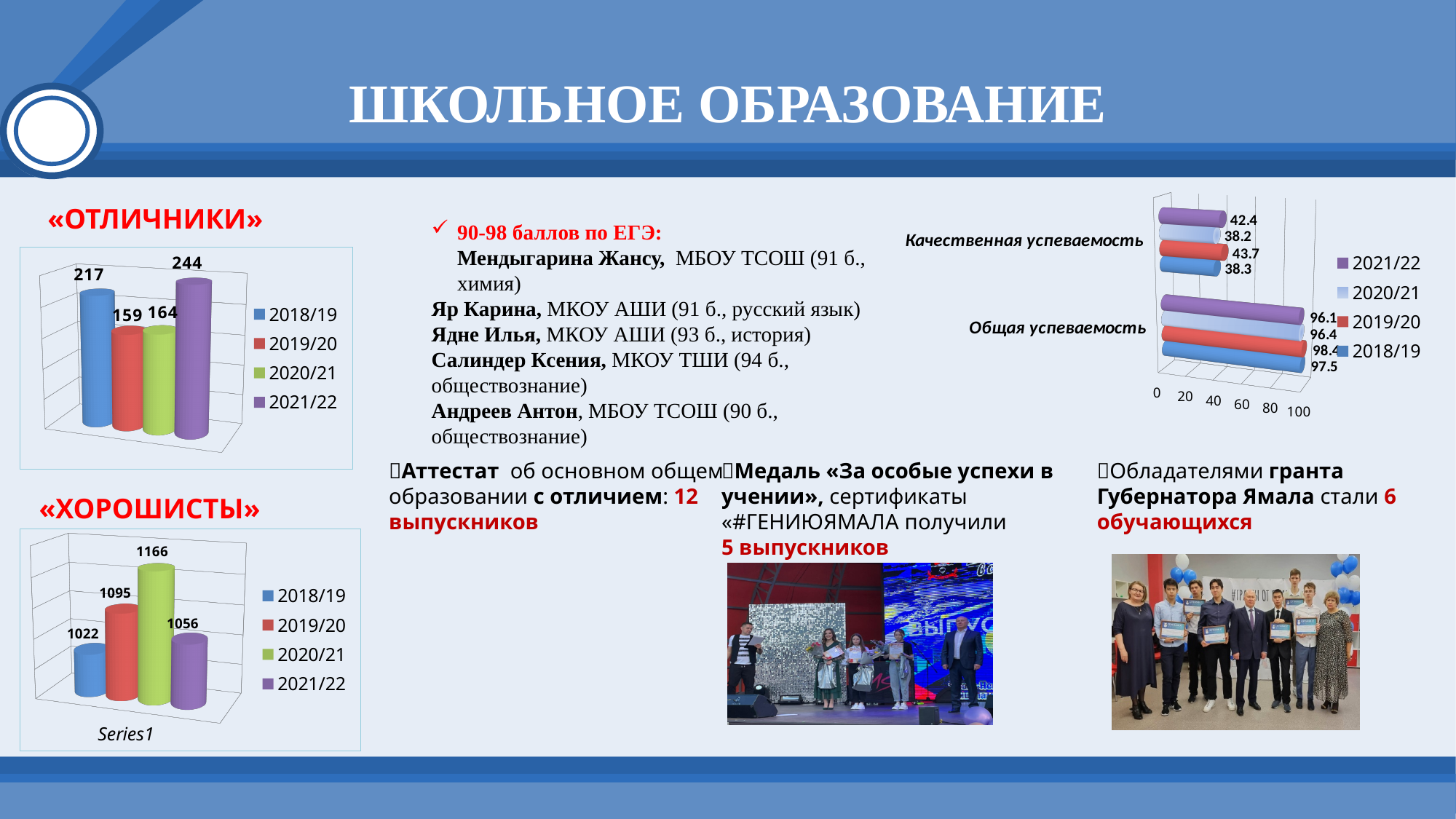
In the «ХОРОШИСТЫ» chart, which is larger, the value for 2019/20 or the value for 2021/22? 2019/20 In the «ОТЛИЧНИКИ» chart, which year has the lowest value? 2019/20 What kind of chart is the «ХОРОШИСТЫ» chart? Bar chart How many series does the legend of the «ОТЛИЧНИКИ» chart list? 4 In the «ХОРОШИСТЫ» chart, what is the value for 2020/21? 1166 In the chart on the right, what is the value of Качественная успеваемость for 2020/21? 38.2 In the «ОТЛИЧНИКИ» chart, what is the value for 2021/22? 244 In the «ХОРОШИСТЫ» chart, which year has the highest value? 2020/21 In the «ОТЛИЧНИКИ» chart, what is the difference between the 2021/22 and 2018/19 values? 27 In the «ХОРОШИСТЫ» chart, what is the difference between the 2020/21 and 2018/19 values? 144 In the chart on the right, which year has the highest Качественная успеваемость? 2019/20 In the chart on the right, what is the value of Общая успеваемость for 2019/20? 98.4